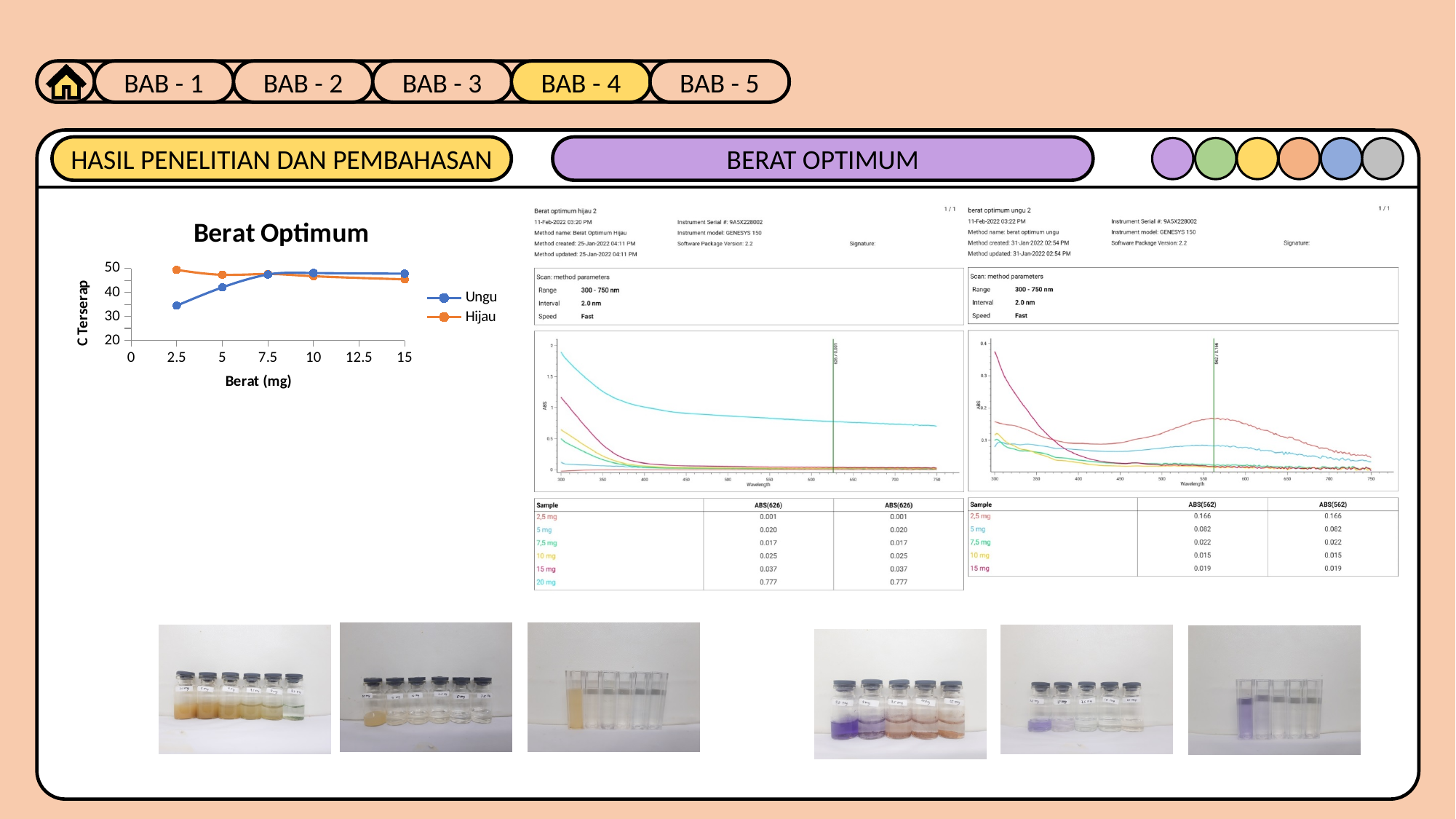
In the "Berat Optimum" chart, is the Hijau value at 2.5 mg greater or less than 40? greater In the "Berat Optimum" chart, is the Hijau value at 15 mg greater or less than 40? greater In the "Berat Optimum" chart, is the Ungu value at 2.5 mg greater or less than 40? less What is the x-axis title of the "Berat Optimum" chart? Berat (mg) In the "Berat Optimum" chart, which series has the larger value at 2.5 mg, Ungu or Hijau? Hijau How many series does the legend of the "Berat Optimum" chart list? 2 What are the series names in the legend of the "Berat Optimum" chart? Ungu and Hijau What kind of chart is the "Berat Optimum" chart? line chart How many data points does the Ungu series have in the "Berat Optimum" chart? 5 In the "Berat Optimum" chart, at which Berat (mg) is the Ungu series lowest? 2.5 In the "Berat Optimum" chart, does the Ungu series generally rise or fall as Berat (mg) increases? rise